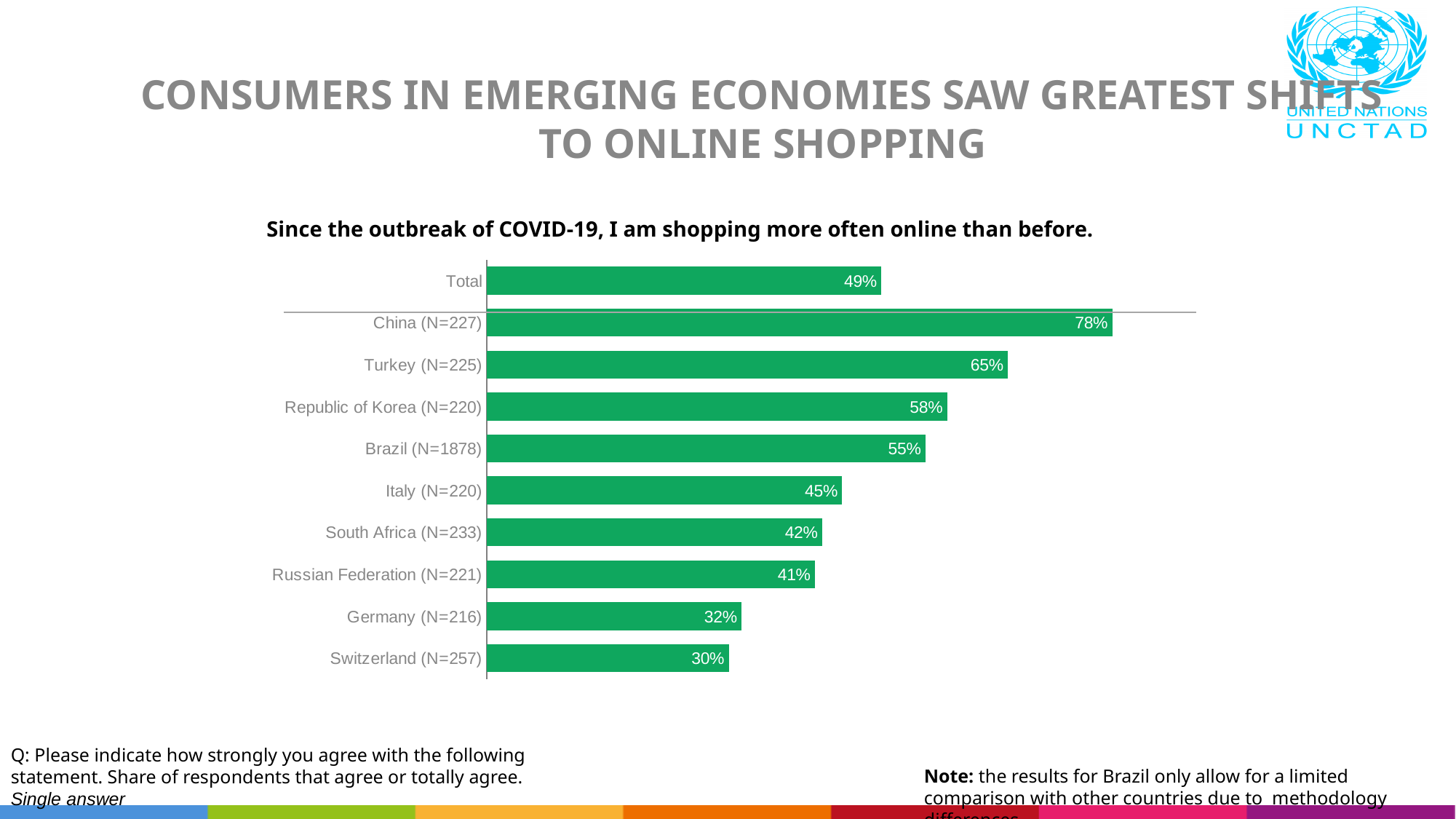
Which country has the lowest value? Switzerland (N=257) Which is larger, the value for Italy (N=220) or the value for South Africa (N=233)? Italy (N=220) What is the difference between the values for Turkey (N=225) and Germany (N=216)? 33% What kind of chart is shown? Bar chart How many country bars are shown, excluding Total? 9 What is the value for Brazil (N=1878)? 55% What is the value for China (N=227)? 78% What is the title of the chart? Since the outbreak of COVID-19, I am shopping more often online than before. Which country has the highest value? China (N=227) What is the difference between the value for Republic of Korea (N=220) and the Total? 9% What is the value for Total? 49% What colour are the bars in the chart? Green